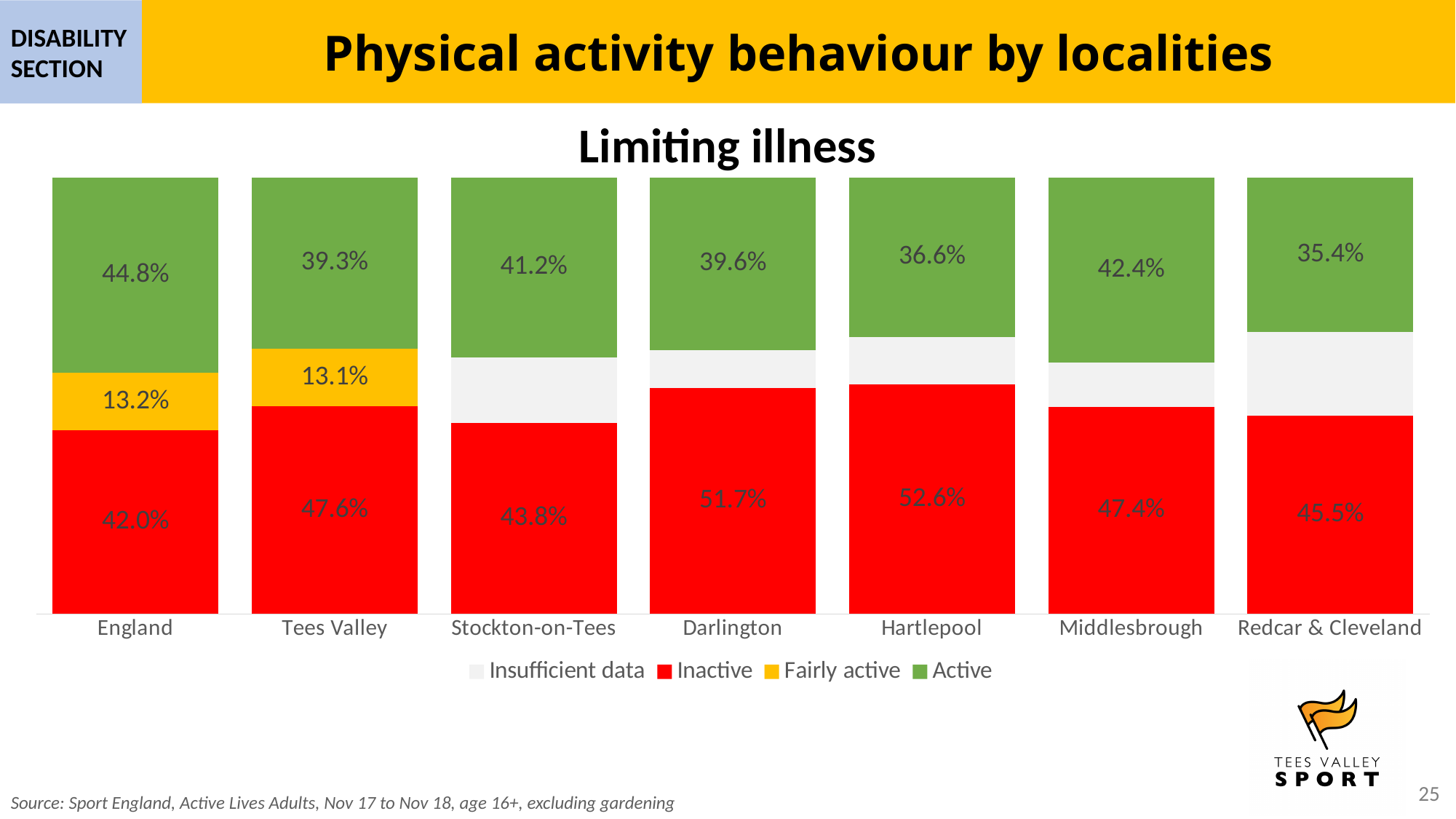
Which has a larger Active value, England or Tees Valley? England What kind of chart is shown? Stacked bar chart What is the total of the three labelled segments in the England bar? 100.0% What is the title of the chart? Limiting illness Which locality has the lowest Active value? Redcar & Cleveland What is the Active value for Middlesbrough? 42.4% What is the Fairly active value for Tees Valley? 13.1% What is the difference between the Inactive values for Hartlepool and England? 10.6 percentage points What is the Inactive value for Darlington? 51.7% How many series does the legend list? 4 Which locality has the highest Inactive value? Hartlepool How many localities are shown on the x axis? 7